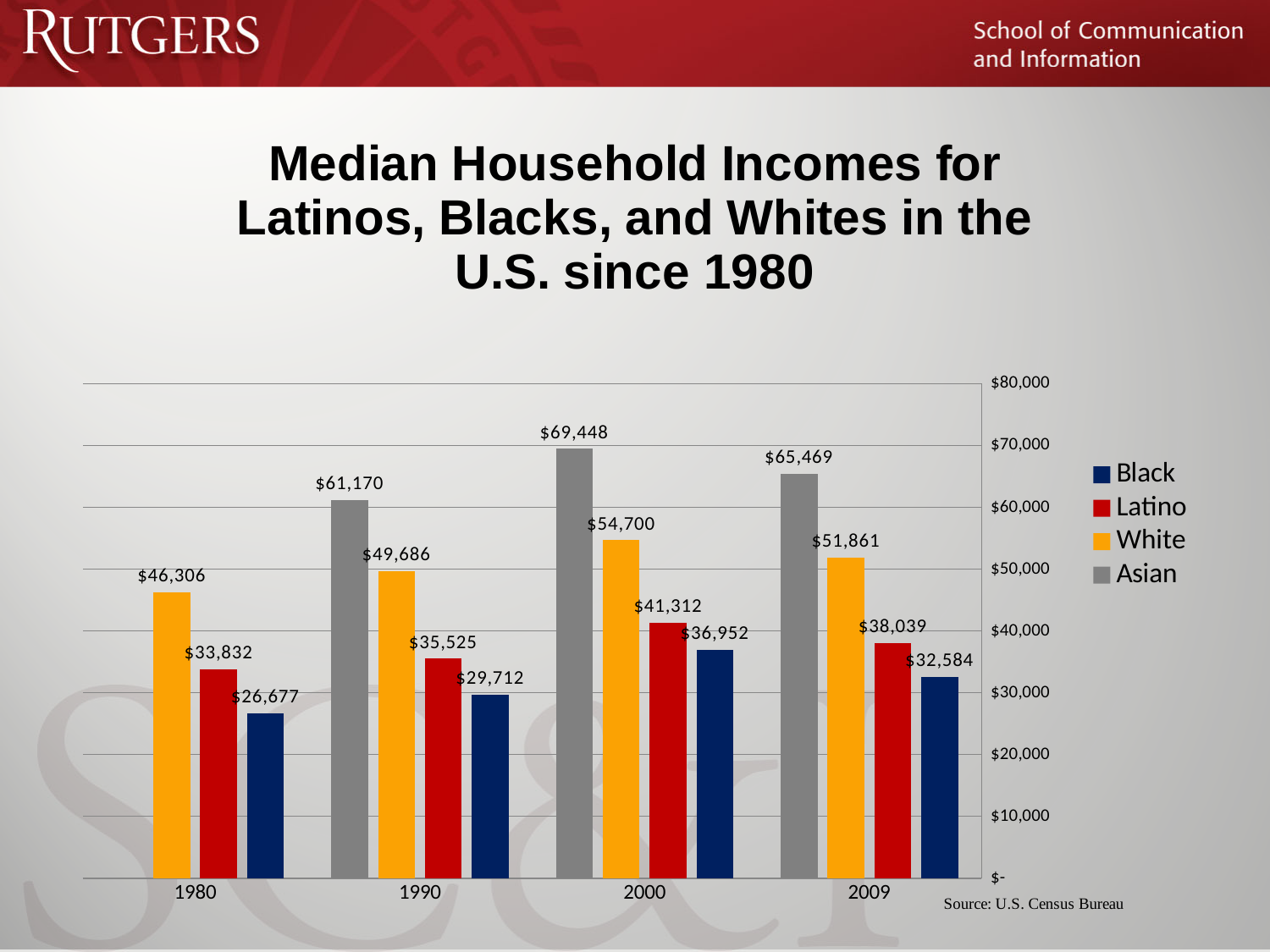
What is the median household income for Latino households in 2009? $38,039 Is the Asian median household income in 2009 greater or less than $60,000? greater What is the difference between the White and Latino median household incomes in 1990? $14,161 In which year is the Asian median household income highest? 2000 What is the median household income for Asian households in 1990? $61,170 In which year is the Black median household income lowest? 1980 What is the median household income for Black households in 1980? $26,677 What kind of chart is shown on the slide? bar chart How many series does the legend list? 4 What is the median household income for White households in 2000? $54,700 Which is larger in 2009: the Latino median household income or the Black median household income? Latino How many years are shown on the x axis? 4